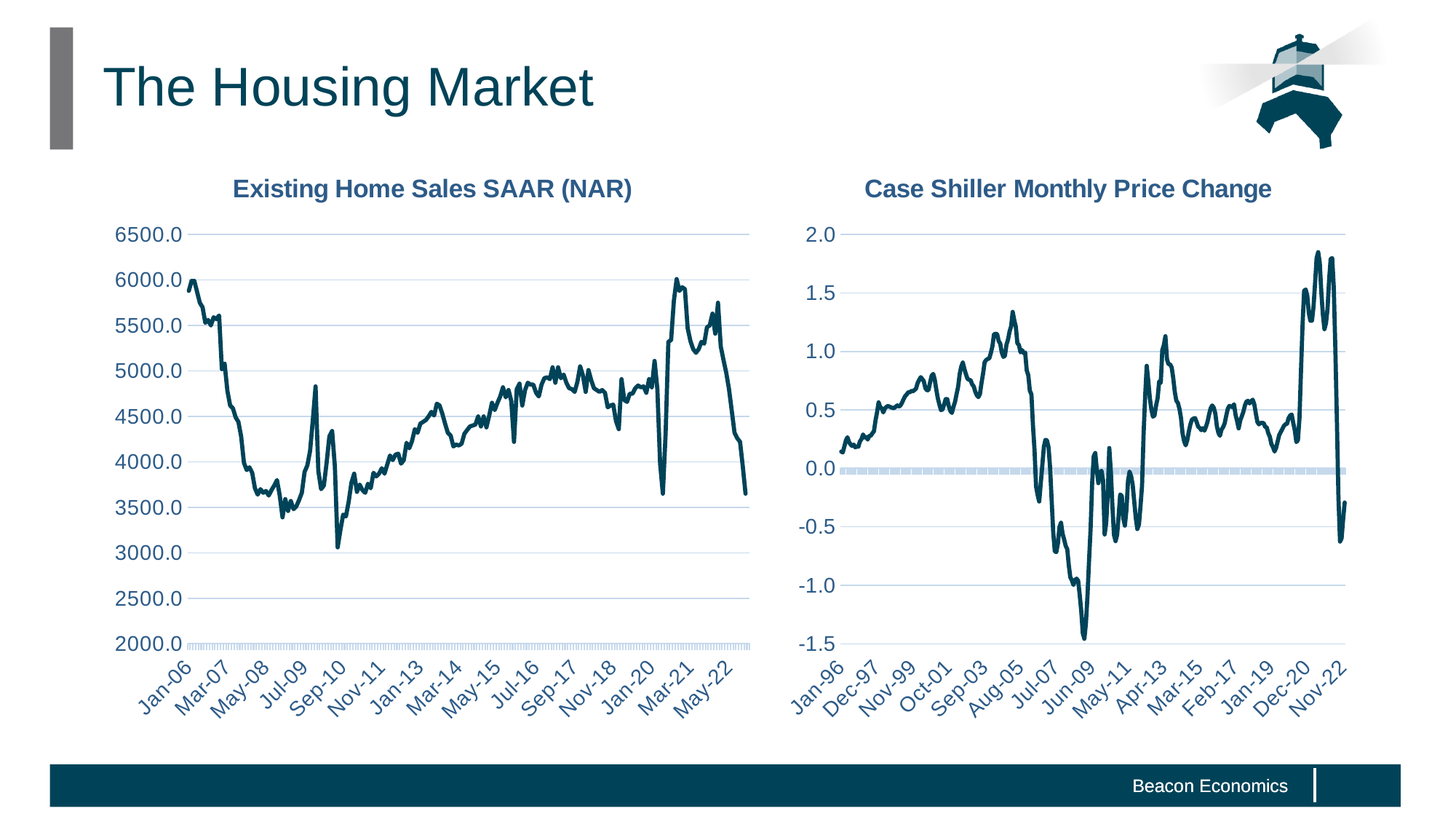
In the 'Existing Home Sales SAAR (NAR)' chart, is the lowest value on the line greater or less than 3500? less What kind of chart is the 'Case Shiller Monthly Price Change' chart? line chart In the 'Existing Home Sales SAAR (NAR)' chart, do values rise or fall between Jan-06 and May-08? fall What is the title of the chart on the right side of the slide? Case Shiller Monthly Price Change In the 'Existing Home Sales SAAR (NAR)' chart, is the value at Jan-06 greater or less than 5500? greater In the 'Existing Home Sales SAAR (NAR)' chart, do values generally rise or fall between Sep-10 and Sep-17? rise How many charts are shown on the slide? 2 In the 'Case Shiller Monthly Price Change' chart, do values rise or fall between Aug-05 and Jun-09? fall In the 'Case Shiller Monthly Price Change' chart, is the highest value on the line greater or less than 1.5? greater What kind of chart is the 'Existing Home Sales SAAR (NAR)' chart? line chart What is the lowest value shown on the y-axis of the 'Case Shiller Monthly Price Change' chart? -1.5